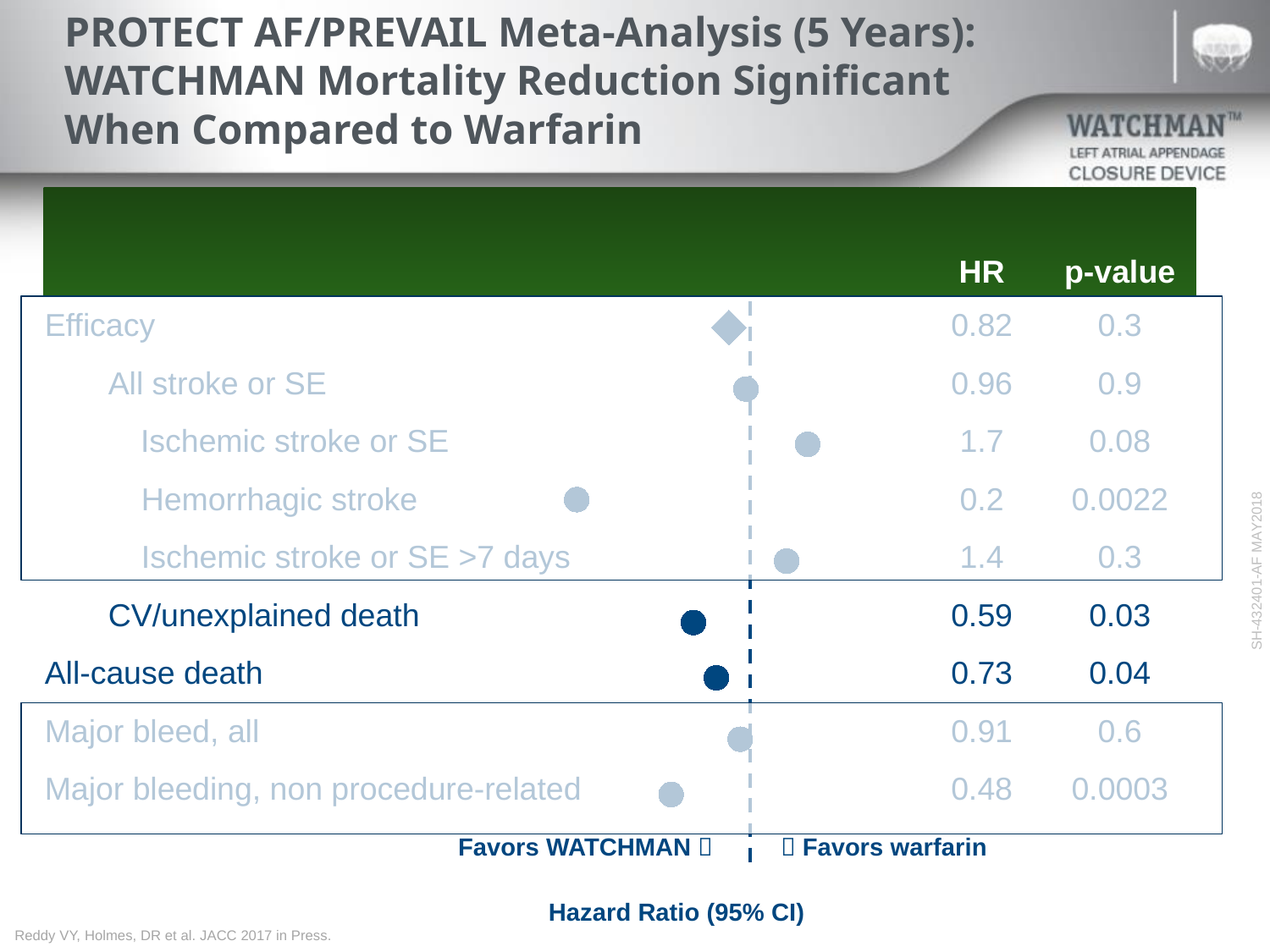
Which side of the dashed line is labelled as favoring WATCHMAN? Left What is the label of the horizontal axis of the chart? Hazard Ratio (95% CI) What kind of chart is shown on the slide? Forest plot (dot plot of hazard ratios) How many outcomes are plotted on the chart? 9 What is the p-value shown for Hemorrhagic stroke? 0.0022 Is the hazard ratio for Ischemic stroke or SE >7 days greater or less than 1? greater Which has the larger hazard ratio, All-cause death or CV/unexplained death? All-cause death Which outcome has the lowest hazard ratio on the slide? Hemorrhagic stroke Which outcome has the highest hazard ratio on the slide? Ischemic stroke or SE What is the hazard ratio (HR) shown for All-cause death? 0.73 What is the difference between the HR for Ischemic stroke or SE and the HR for Hemorrhagic stroke? 1.5 What is the HR shown for Major bleeding, non procedure-related? 0.48